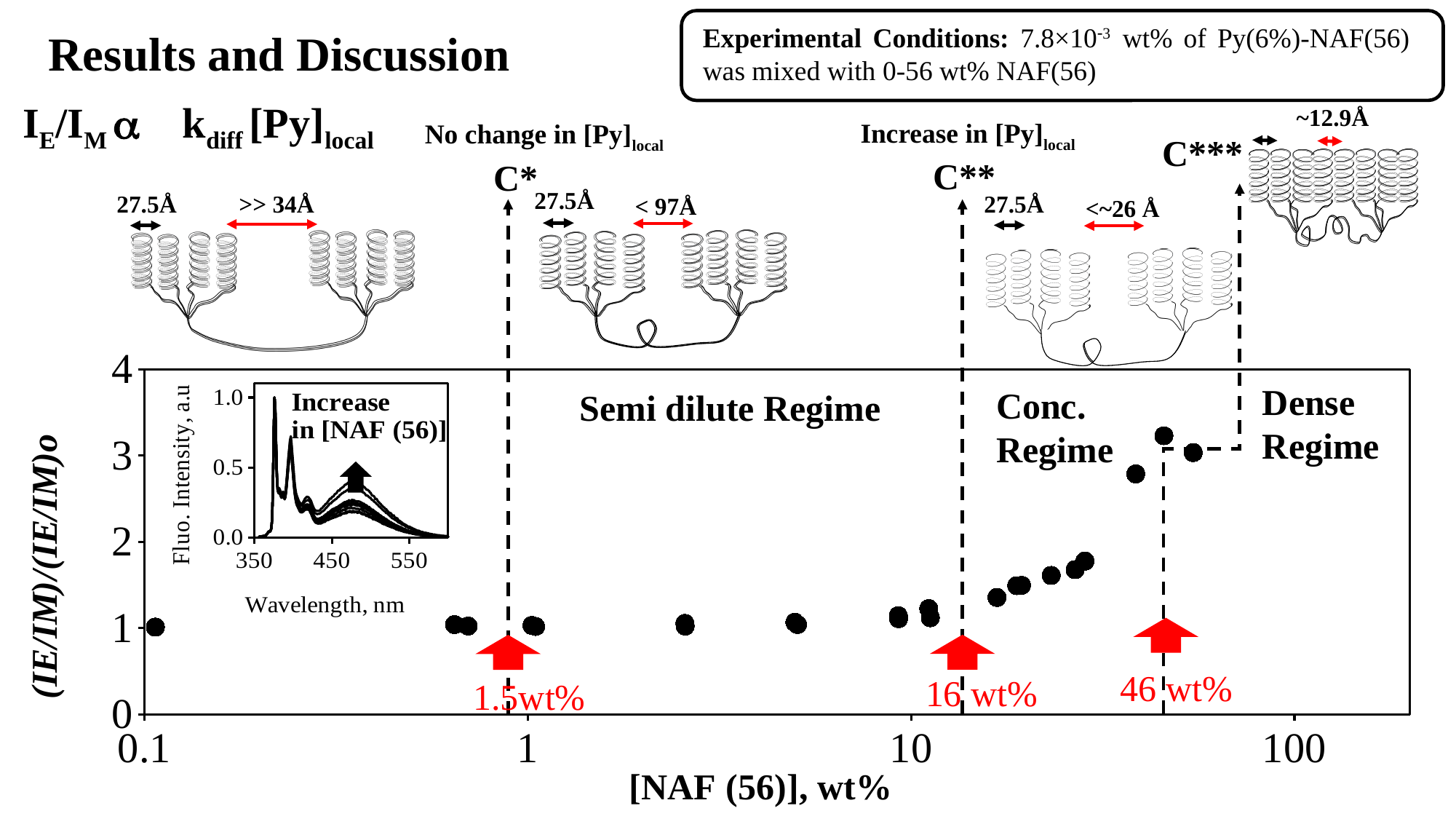
What kind of chart is the main chart plotting (IE/IM)/(IE/IM)o against [NAF (56)], wt%? scatter chart In the inset chart, what is the highest tick value shown on the Fluo. Intensity axis? 1.0 In the main chart, which is larger: the value at 46 wt% or the value at 1.5 wt%? 46 wt% What is the x-axis label of the inset chart? Wavelength, nm In the main chart, what concentration is marked at the C** transition? 16 wt% In the main chart, is the value of (IE/IM)/(IE/IM)o at 46 wt% greater or less than 3? greater In the main chart, what concentration is marked at the C* transition? 1.5wt% How many regimes are labelled on the main chart? 3 In the main chart, do the values rise or fall as [NAF (56)] increases from 10 wt% to 46 wt%? rise In the main chart, is the value of (IE/IM)/(IE/IM)o at 16 wt% greater or less than 2? less In the main chart, is the value of (IE/IM)/(IE/IM)o at 1.5 wt% greater or less than 2? less In the main chart, what concentration is marked at the C*** transition? 46 wt%